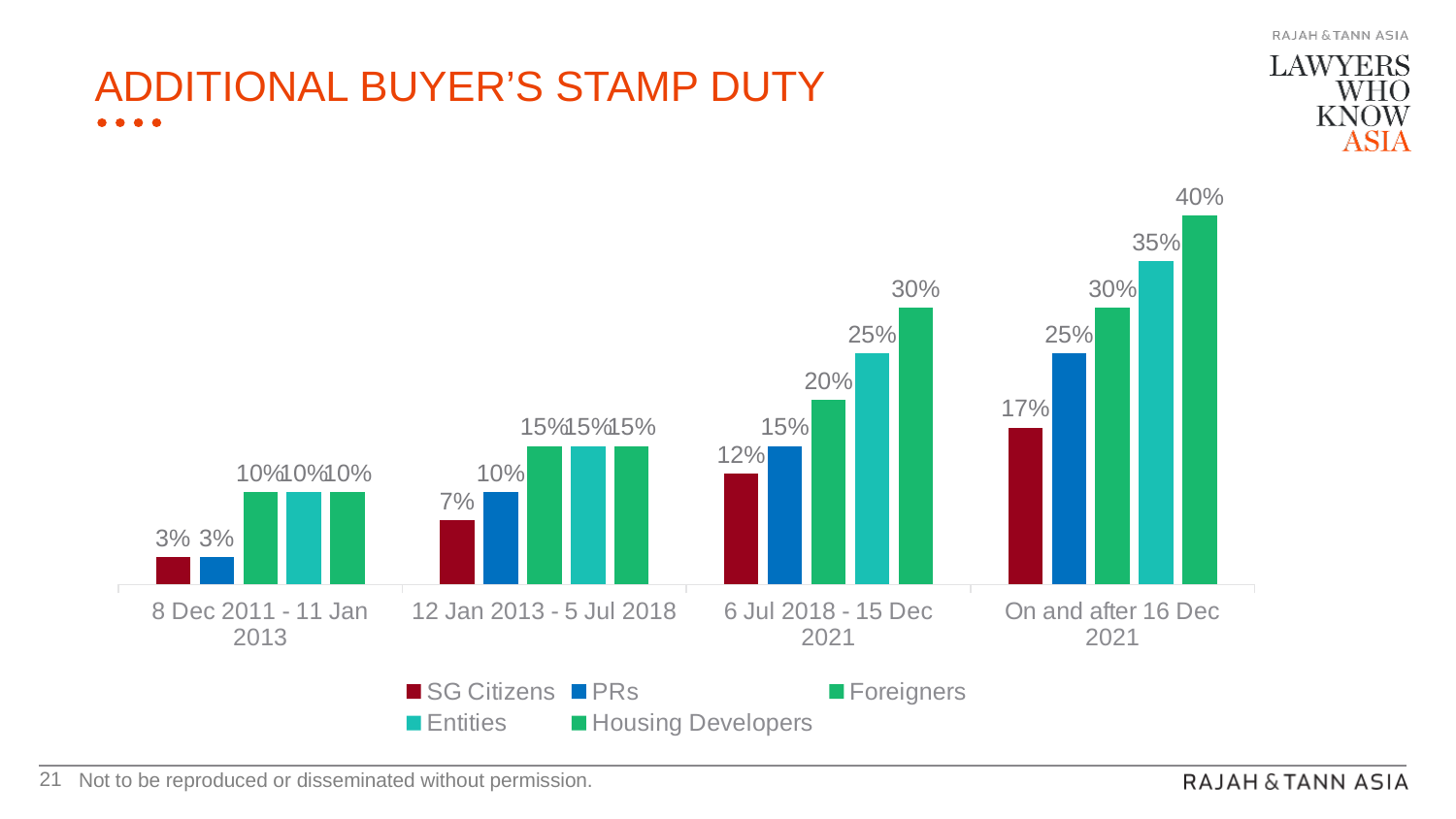
What is the difference between the Entities value and the SG Citizens value in the period 'On and after 16 Dec 2021'? 18% Do the SG Citizens values rise or fall across the periods from left to right? Rise Which series has the highest value in the period 'On and after 16 Dec 2021'? Housing Developers Which series has the lowest value in the period '6 Jul 2018 - 15 Dec 2021'? SG Citizens What is the value for PRs in the period '6 Jul 2018 - 15 Dec 2021'? 15% What is the value for SG Citizens in the period '12 Jan 2013 - 5 Jul 2018'? 7% How many time periods are shown on the x axis? 4 What is the value for Housing Developers in the period 'On and after 16 Dec 2021'? 40% What type of chart is shown on the slide? Bar chart How many series does the legend list? 5 What is the value for SG Citizens in the period 'On and after 16 Dec 2021'? 17% Which is larger: the PRs value in '6 Jul 2018 - 15 Dec 2021' or the PRs value in 'On and after 16 Dec 2021'? On and after 16 Dec 2021